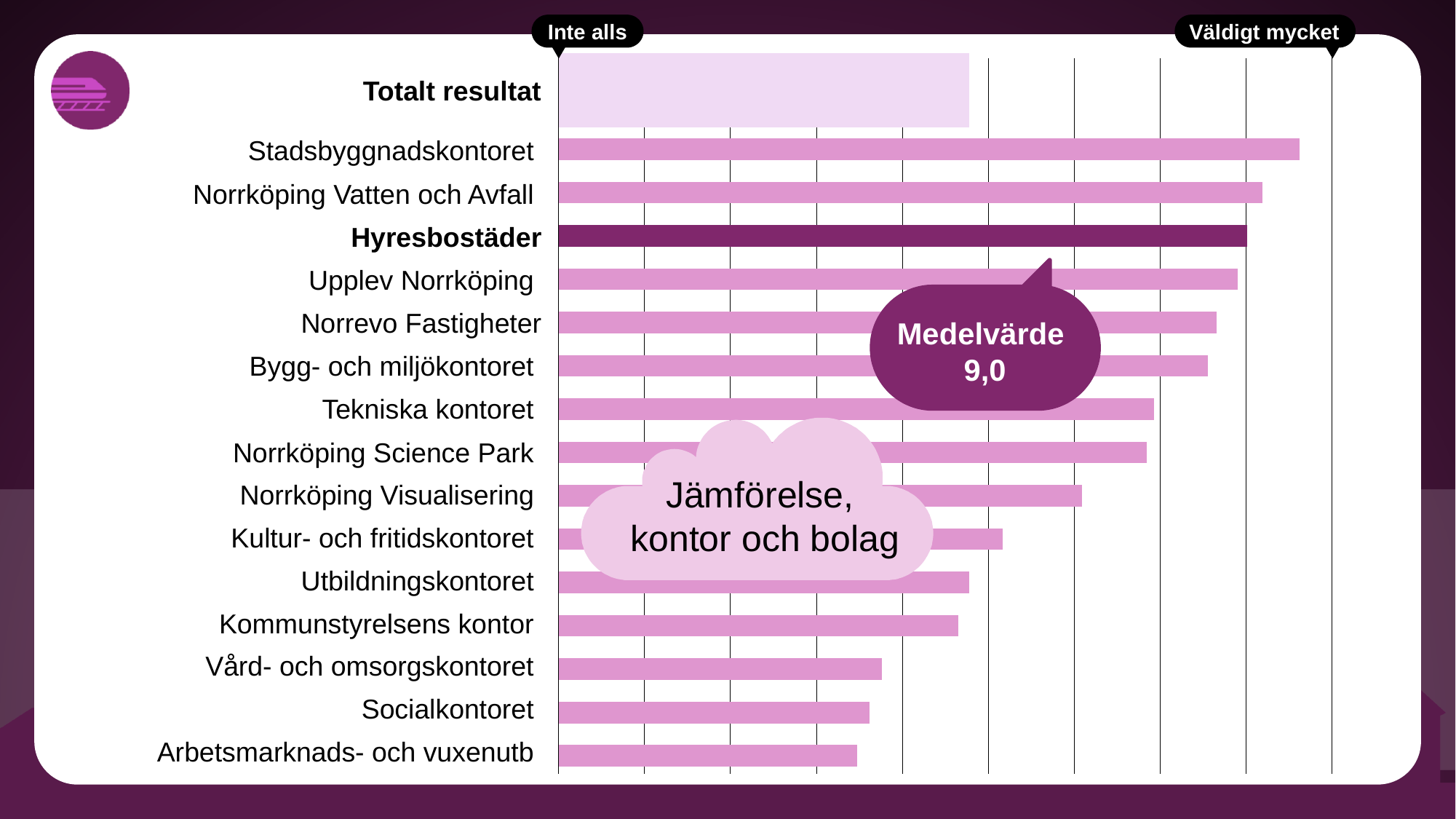
What title is shown in the cloud shape on the chart? Jämförelse, kontor och bolag Which has the longer bar, Norrköping Visualisering or Kultur- och fritidskontoret? Norrköping Visualisering Which has the longer bar, Norrköping Vatten och Avfall or Norrevo Fastigheter? Norrköping Vatten och Avfall What kind of chart is shown on the slide? bar chart Which organisation has the shortest bar in the chart? Arbetsmarknads- och vuxenutb Which organisation has the longest bar in the chart? Stadsbyggnadskontoret Do the bars get longer or shorter going down the list from Stadsbyggnadskontoret to Arbetsmarknads- och vuxenutb? shorter Which has the longer bar, Totalt resultat or Hyresbostäder? Hyresbostäder What is the mean value (Medelvärde) shown in the callout for Hyresbostäder? 9,0 How many organisations (excluding Totalt resultat) are listed in the chart? 15 What are the two labels at the ends of the horizontal axis? Inte alls and Väldigt mycket